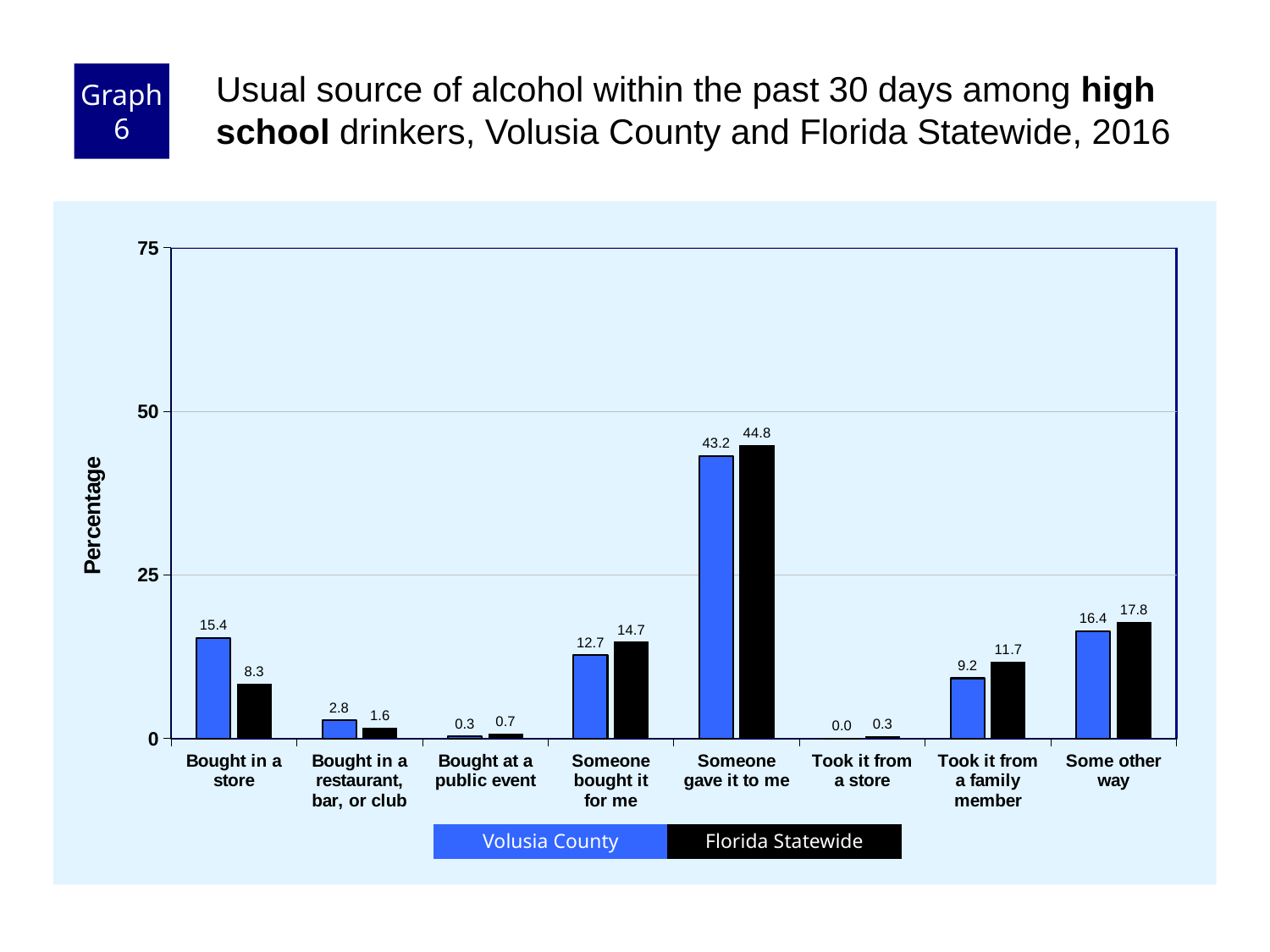
How many categories are shown on the x axis? 8 What is the difference between the Florida Statewide and Volusia County values for "Some other way"? 1.4 How many series does the legend list? 2 What is the Volusia County value for "Bought in a store"? 15.4 What is the Volusia County value for "Someone gave it to me"? 43.2 What is the Florida Statewide value for "Took it from a family member"? 11.7 Which category has the lowest Volusia County value? Took it from a store Which category has the highest Florida Statewide value? Someone gave it to me What kind of chart is shown on the slide? Bar chart For "Someone bought it for me", which is larger: Volusia County or Florida Statewide? Florida Statewide What is the difference between the Volusia County and Florida Statewide values for "Bought in a store"? 7.1 Is the Florida Statewide value for "Someone gave it to me" greater or less than 25? greater